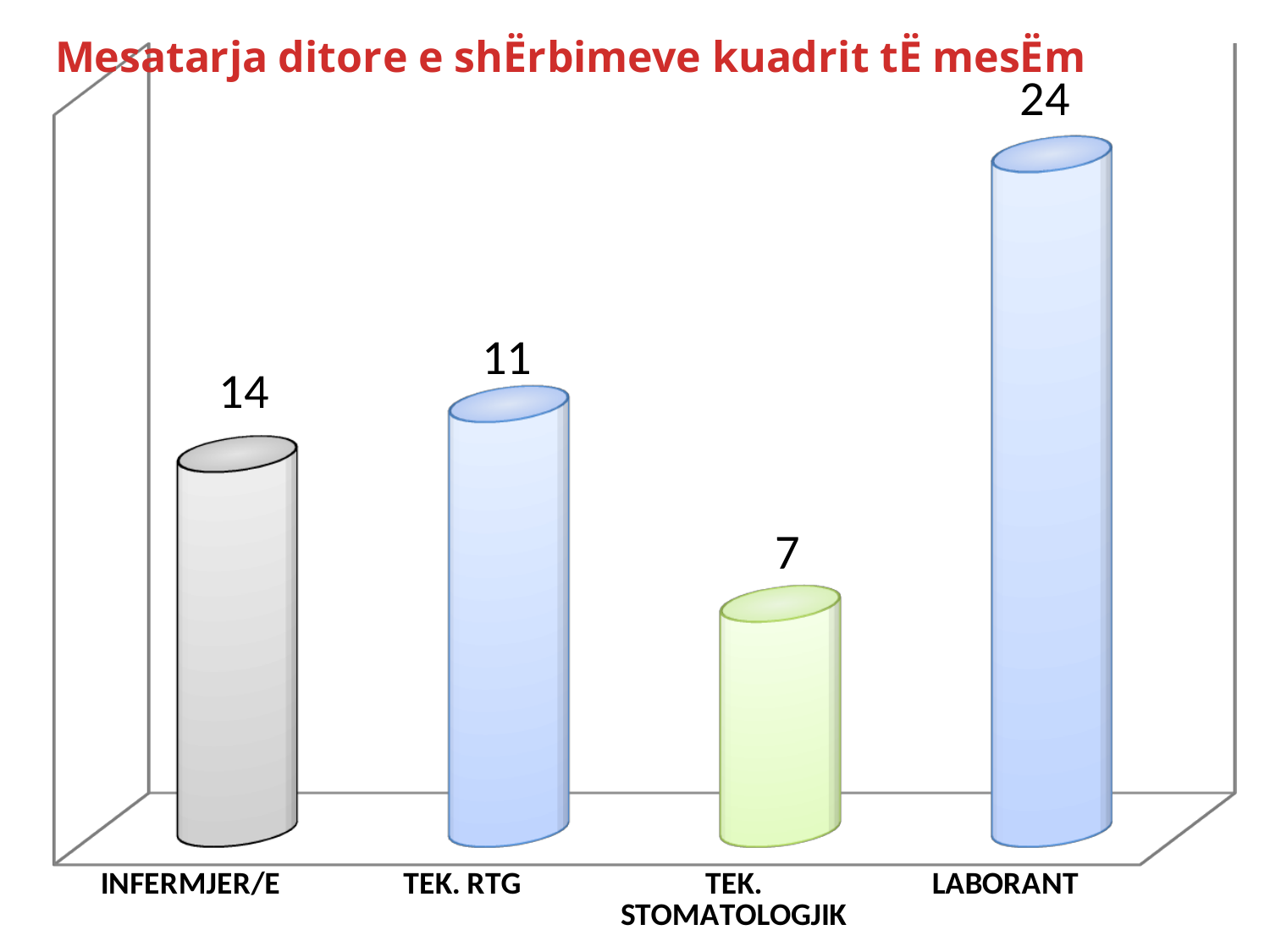
What is the value for TEK. STOMATOLOGJIK? 7 What is the value for INFERMJER/E? 14 What is the title of the chart? Mesatarja ditore e shËrbimeve kuadrit tË mesËm What kind of chart is shown on the slide? Bar chart What is the value for TEK. RTG? 11 What is the difference between the values for LABORANT and INFERMJER/E? 10 What is the value for LABORANT? 24 What is the difference between the values for TEK. RTG and TEK. STOMATOLOGJIK? 4 How many categories are shown on the chart? 4 Which category has the lowest value? TEK. STOMATOLOGJIK Which category has the highest value? LABORANT